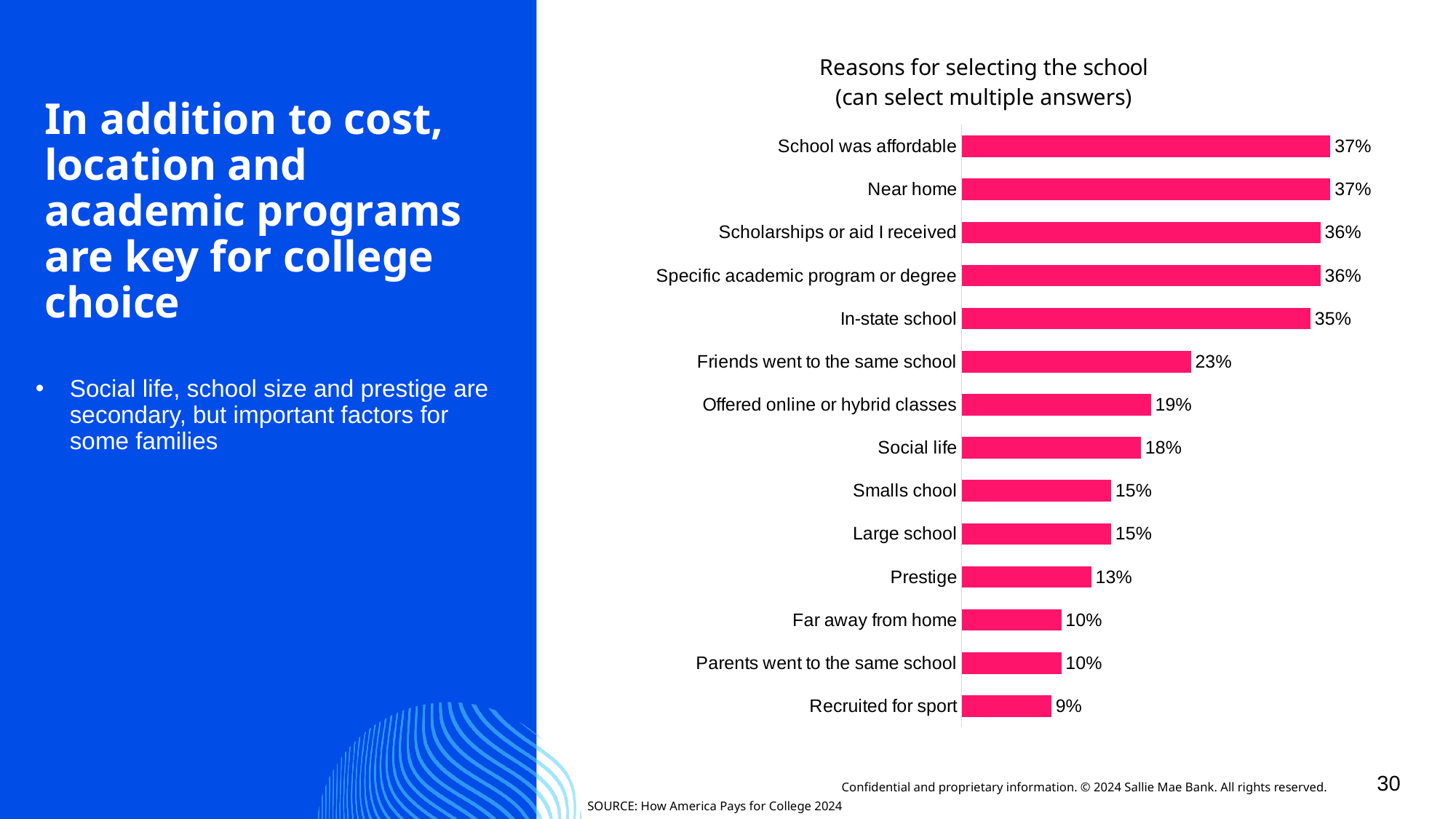
What percentage of respondents selected "Friends went to the same school" as a reason for selecting the school? 23% What is the difference between "Social life" and "Prestige"? 5% What percentage is shown for "In-state school"? 35% What is the value shown for "Prestige"? 13% Which is larger: "Social life" or "Large school"? Social life What type of chart is shown on the slide? Bar chart What is the value for "Offered online or hybrid classes"? 19% Which reason has the lowest percentage in the chart? Recruited for sport How many reasons (categories) are shown in the chart? 14 What is the difference in percentage points between "Near home" and "Far away from home"? 27 What is the title of the chart? Reasons for selecting the school (can select multiple answers) Which is larger: the value for "Scholarships or aid I received" or the value for "Friends went to the same school"? Scholarships or aid I received